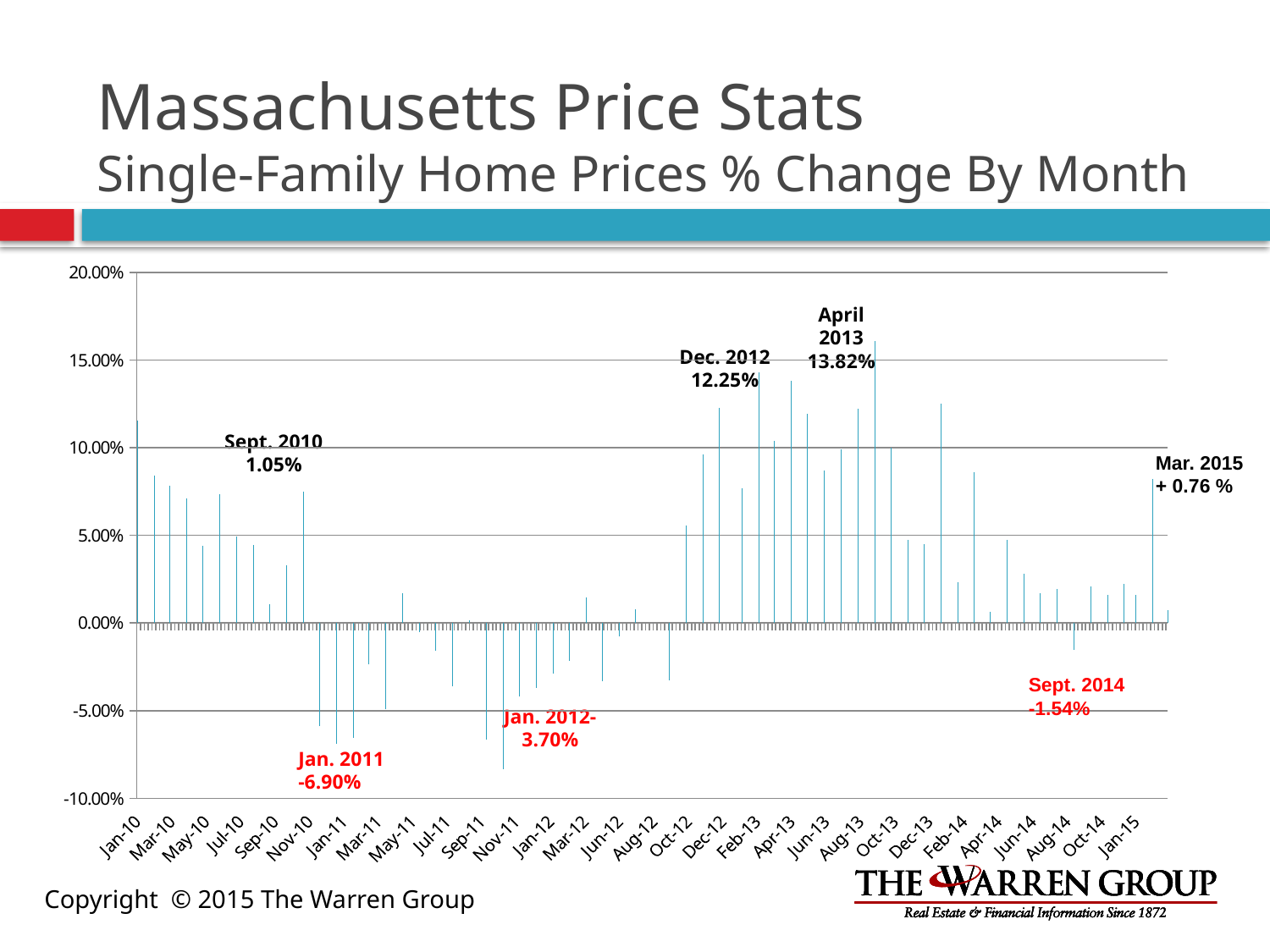
Do the values rise or fall from Jan-10 to May-10? fall What was the single-family home price % change in Dec. 2012? 12.25% What is the highest value shown on the vertical axis? 20.00% What was the single-family home price % change in Sept. 2014? -1.54% Which of the labelled months had the larger price change, Dec. 2012 or April 2013? April 2013 Which of the labelled months had the lower price change, Jan. 2011 or Jan. 2012? Jan. 2011 What was the single-family home price % change in April 2013? 13.82% What was the single-family home price % change in Mar. 2015? + 0.76 % Is the value for Jan-10 greater or less than 10.00%? greater What type of chart is shown on the slide? bar chart What was the single-family home price % change in Jan. 2011? -6.90% What is the difference in percentage points between the April 2013 value (13.82%) and the Dec. 2012 value (12.25%)? 1.57 percentage points